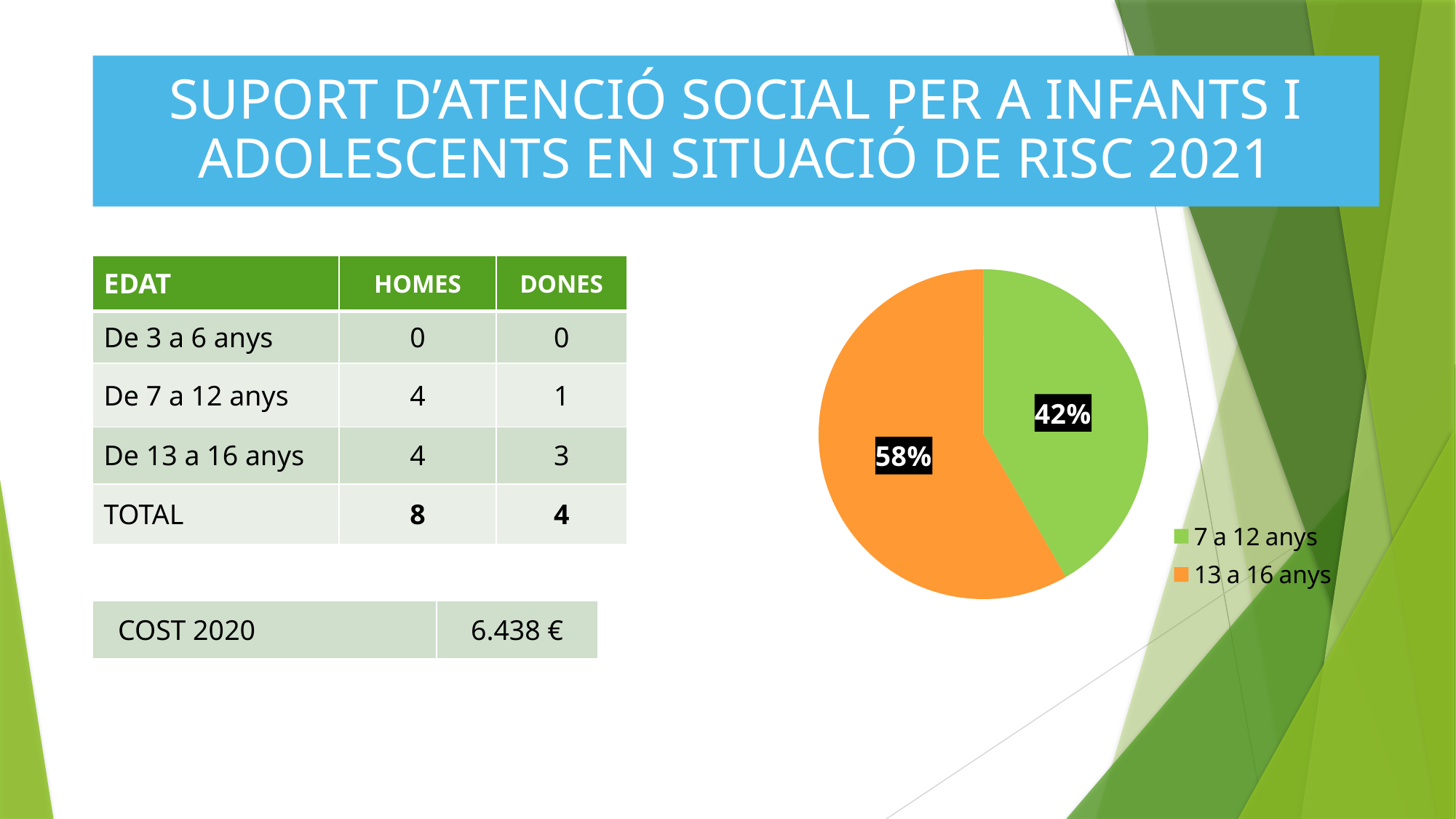
How many entries does the pie chart legend list? 2 What share of the pie chart does the '13 a 16 anys' slice represent? 58% What colour is the '13 a 16 anys' slice in the pie chart? orange Which slice of the pie chart is the largest? 13 a 16 anys What colour is the '7 a 12 anys' slice in the pie chart? green What share of the pie chart does the '7 a 12 anys' slice represent? 42% What is the difference in percentage points between the '13 a 16 anys' slice and the '7 a 12 anys' slice? 16 Which is larger in the pie chart: the '7 a 12 anys' slice or the '13 a 16 anys' slice? 13 a 16 anys How many slices does the pie chart have? 2 Which slice of the pie chart is the smallest? 7 a 12 anys What kind of chart is shown on the slide? pie chart